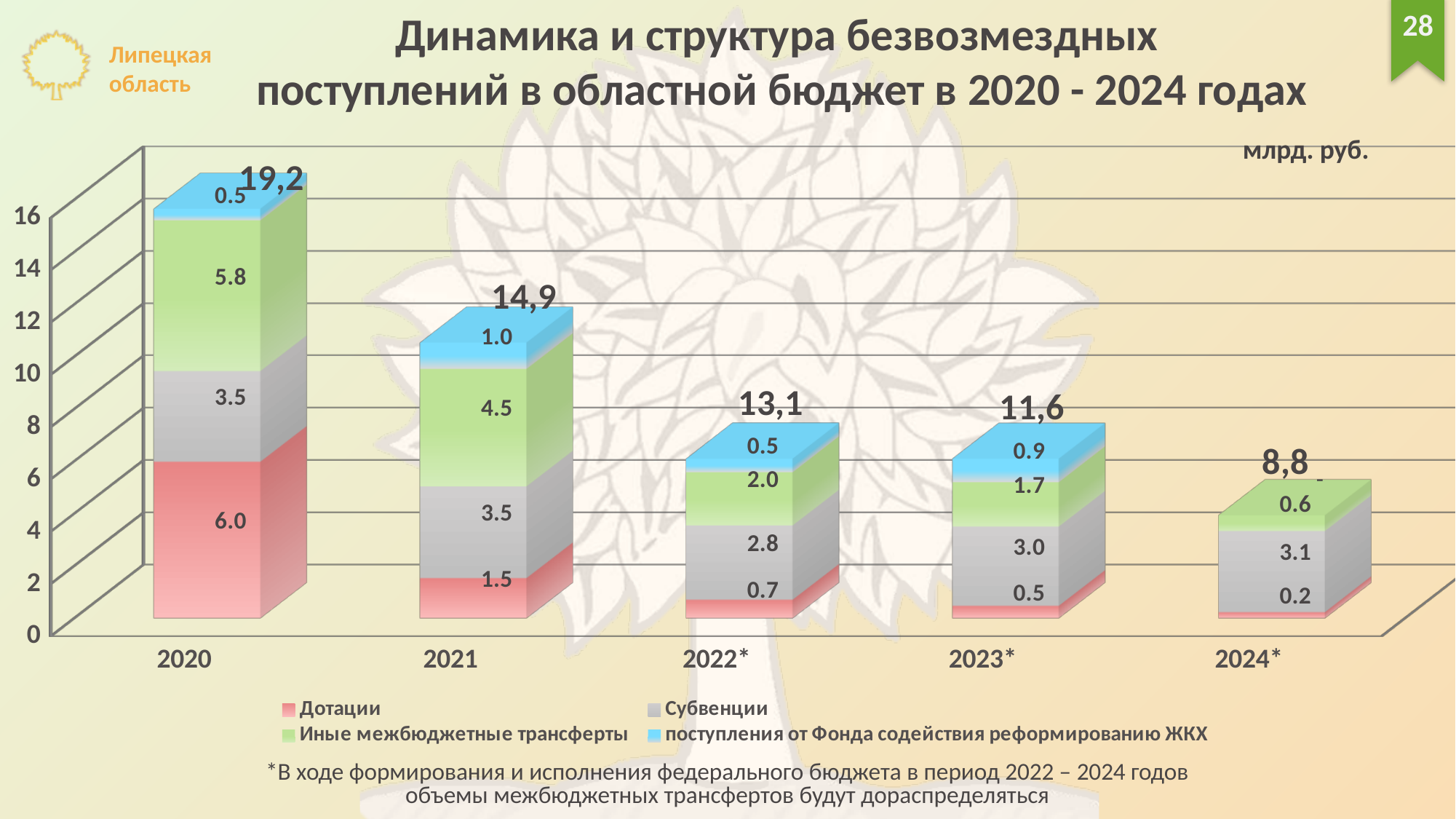
What is the difference between the Дотации values for 2020 and 2021? 4.5 What is the value of the Дотации segment for 2020? 6.0 How many years are shown on the x axis? 5 Do the total values rise or fall from 2020 to 2024*? fall What is the value of the Иные межбюджетные трансферты segment for 2021? 4.5 What is the total value shown above the bar for 2020? 19,2 How many series does the legend list? 4 Which year has the lowest total value? 2024* What is the value of the поступления от Фонда содействия реформированию ЖКХ segment for 2021? 1.0 Which is larger, the Иные межбюджетные трансферты value for 2022* or for 2023*? 2022* What is the value of the Субвенции segment for 2023*? 3.0 Which year has the highest total value? 2020